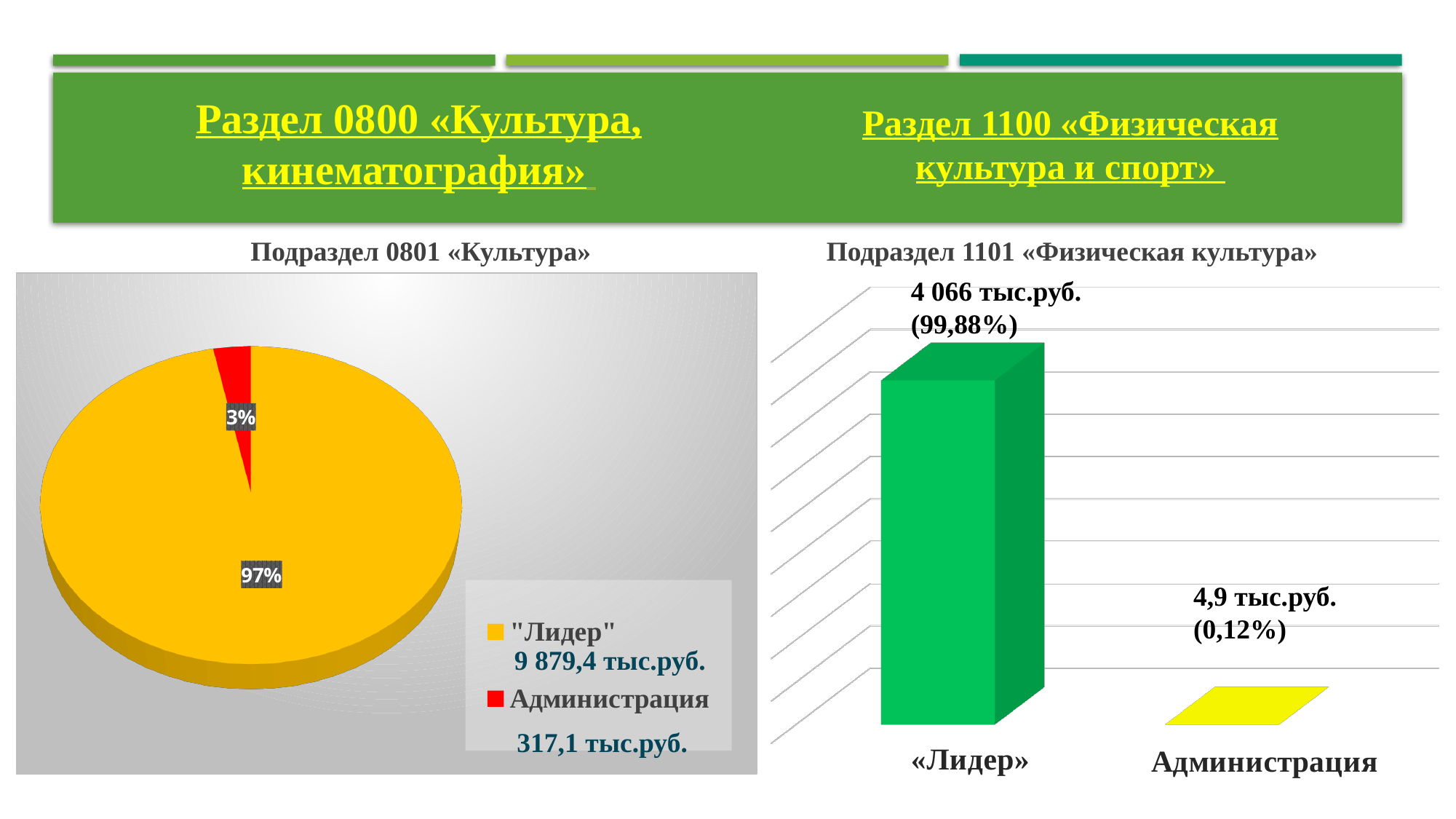
In the bar chart «Подраздел 1101 «Физическая культура»», which category has the lowest value? Администрация What kind of chart is shown under «Подраздел 0801 «Культура»»? Pie chart In the bar chart «Подраздел 1101 «Физическая культура»», what percentage is shown for «Лидер»? 99,88% In the pie chart «Подраздел 0801 «Культура»», what share does the "Лидер" slice have? 97% What kind of chart is shown under «Подраздел 1101 «Физическая культура»»? Bar chart In the bar chart «Подраздел 1101 «Физическая культура»», what is the value for «Лидер»? 4 066 тыс.руб. In the bar chart «Подраздел 1101 «Физическая культура»», what is the value for Администрация? 4,9 тыс.руб. In the pie chart «Подраздел 0801 «Культура»», what amount is shown in the legend for "Лидер"? 9 879,4 тыс.руб. In the pie chart «Подраздел 0801 «Культура»», which slice is the largest? "Лидер" In the pie chart «Подраздел 0801 «Культура»», what share does the Администрация slice have? 3% In the pie chart «Подраздел 0801 «Культура»», what amount is shown in the legend for Администрация? 317,1 тыс.руб. How many entries does the legend of the pie chart «Подраздел 0801 «Культура»» list? 2